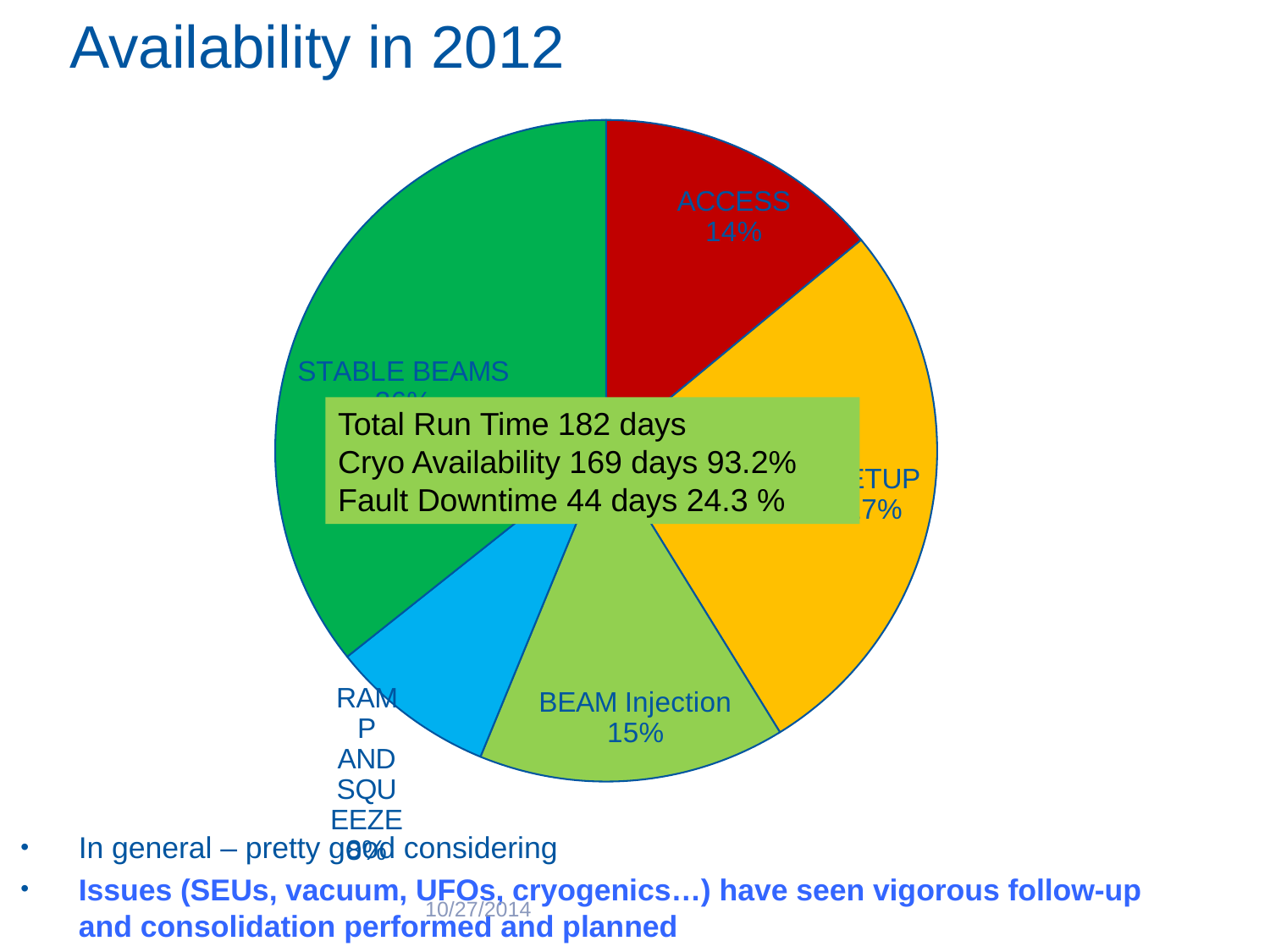
What kind of chart is shown on the slide? pie chart What percentage is shown for the RAMP AND SQUEEZE slice? 8% How many slices does the pie chart have? 5 What is the title of the slide containing the pie chart? Availability in 2012 Which slice is larger, ACCESS or BEAM Injection? BEAM Injection What percentage is shown for the BEAM Injection slice? 15% What percentage is shown for the ACCESS slice? 14% Which slice of the pie is the smallest? RAMP AND SQUEEZE What is the difference in percentage points between the BEAM Injection slice and the RAMP AND SQUEEZE slice? 7% What is the difference in percentage points between the BEAM Injection slice and the ACCESS slice? 1% What share of the pie does the ACCESS slice represent? 14% Which slice of the pie is the largest? STABLE BEAMS